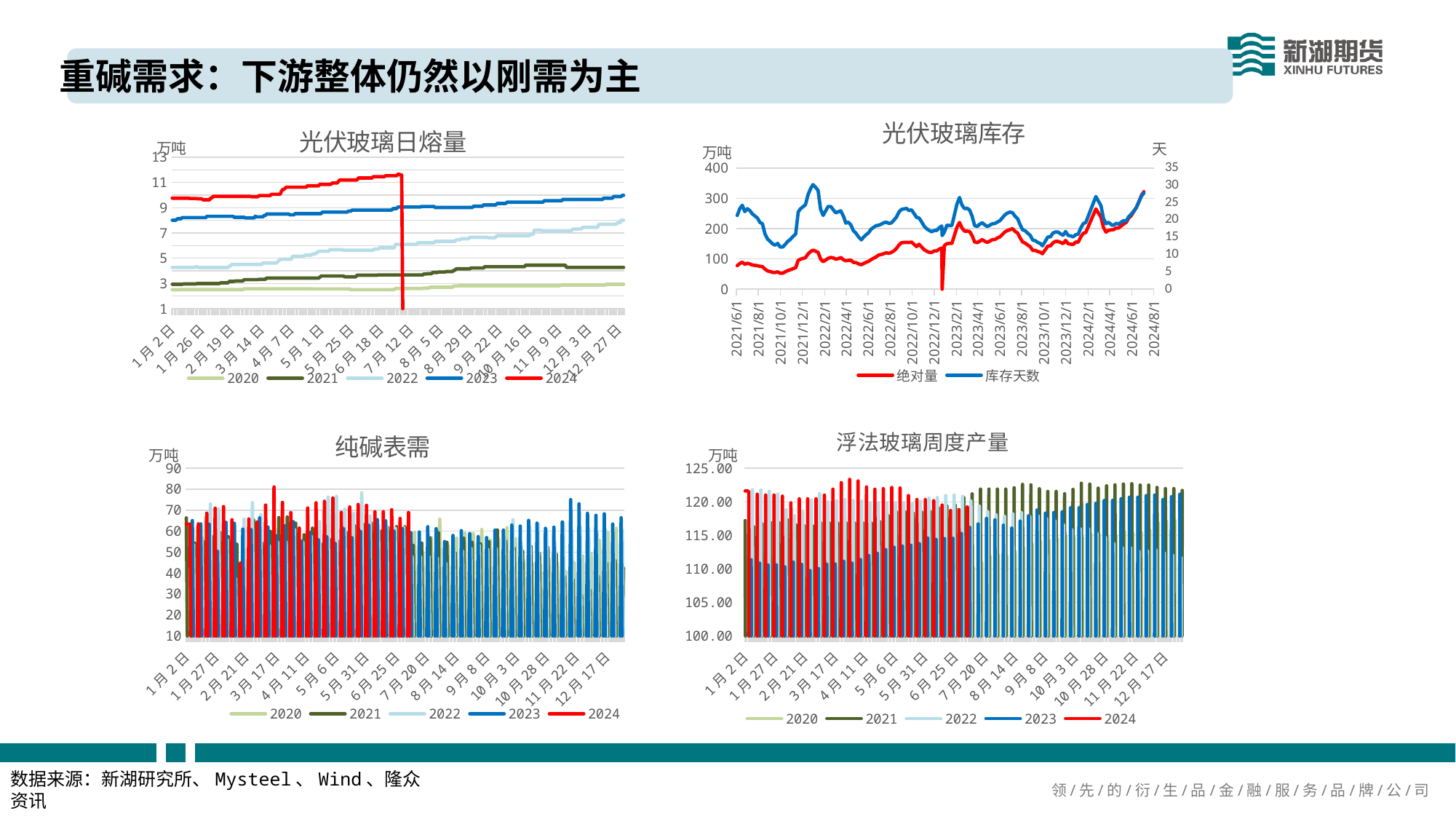
What kind of chart is the 光伏玻璃日熔量 chart (top left)? line chart What kind of chart is the 浮法玻璃周度产量 chart (bottom right)? bar chart In the 光伏玻璃库存 chart, what unit is shown on the right-hand axis? 天 In the 光伏玻璃日熔量 chart, is the value of the 2024 line at 1月2日 greater or less than 9? greater How many series does the legend of the 光伏玻璃日熔量 chart list? 5 How many series does the legend of the 浮法玻璃周度产量 chart list? 5 In the 光伏玻璃日熔量 chart, does the 2023 line rise or fall from 1月2日 to 12月27日? rise In the 光伏玻璃日熔量 chart, which series is higher at 12月27日, 2023 or 2022? 2023 How many series does the legend of the 光伏玻璃库存 chart (top right) list? 2 In the 光伏玻璃日熔量 chart, is the value of the 2023 line at 1月2日 greater or less than 7? greater What kind of chart is the 纯碱表需 chart (bottom left)? bar chart In the 纯碱表需 chart, what colour represents the 2024 series in the legend? red